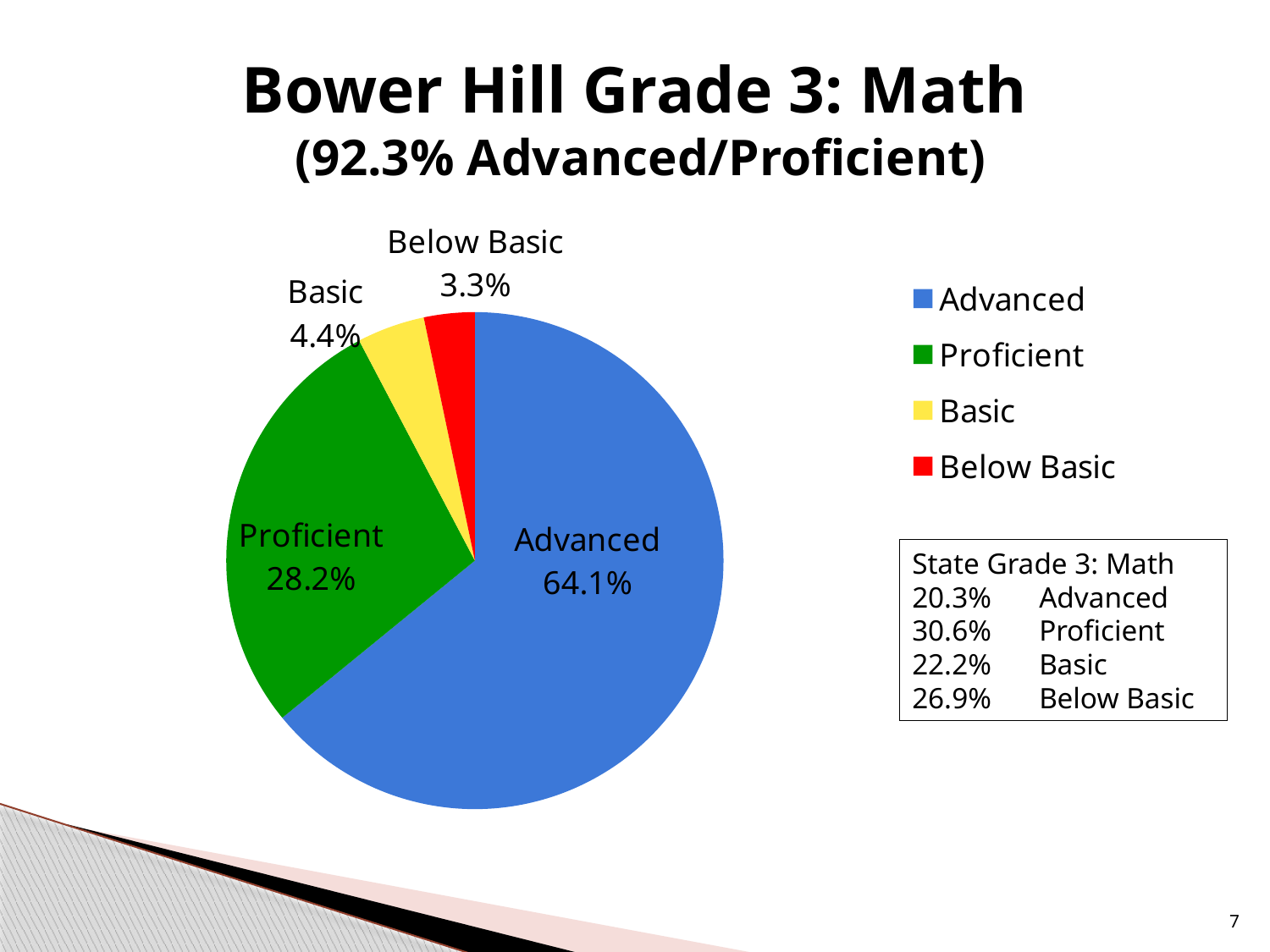
How many entries does the legend list? 4 What colour represents the Proficient slice? Green What percentage of students scored Below Basic? 3.3% Which performance level has the smallest share of the pie? Below Basic Which is larger, the Basic share or the Below Basic share? Basic What percentage of students scored Proficient? 28.2% What percentage of Bower Hill Grade 3 students scored Advanced in Math? 64.1% What is the difference in percentage points between Advanced and Proficient? 35.9 What percentage of students scored Basic? 4.4% Which performance level has the largest share of the pie? Advanced How many slices does the pie chart have? 4 What type of chart is shown on the slide? Pie chart